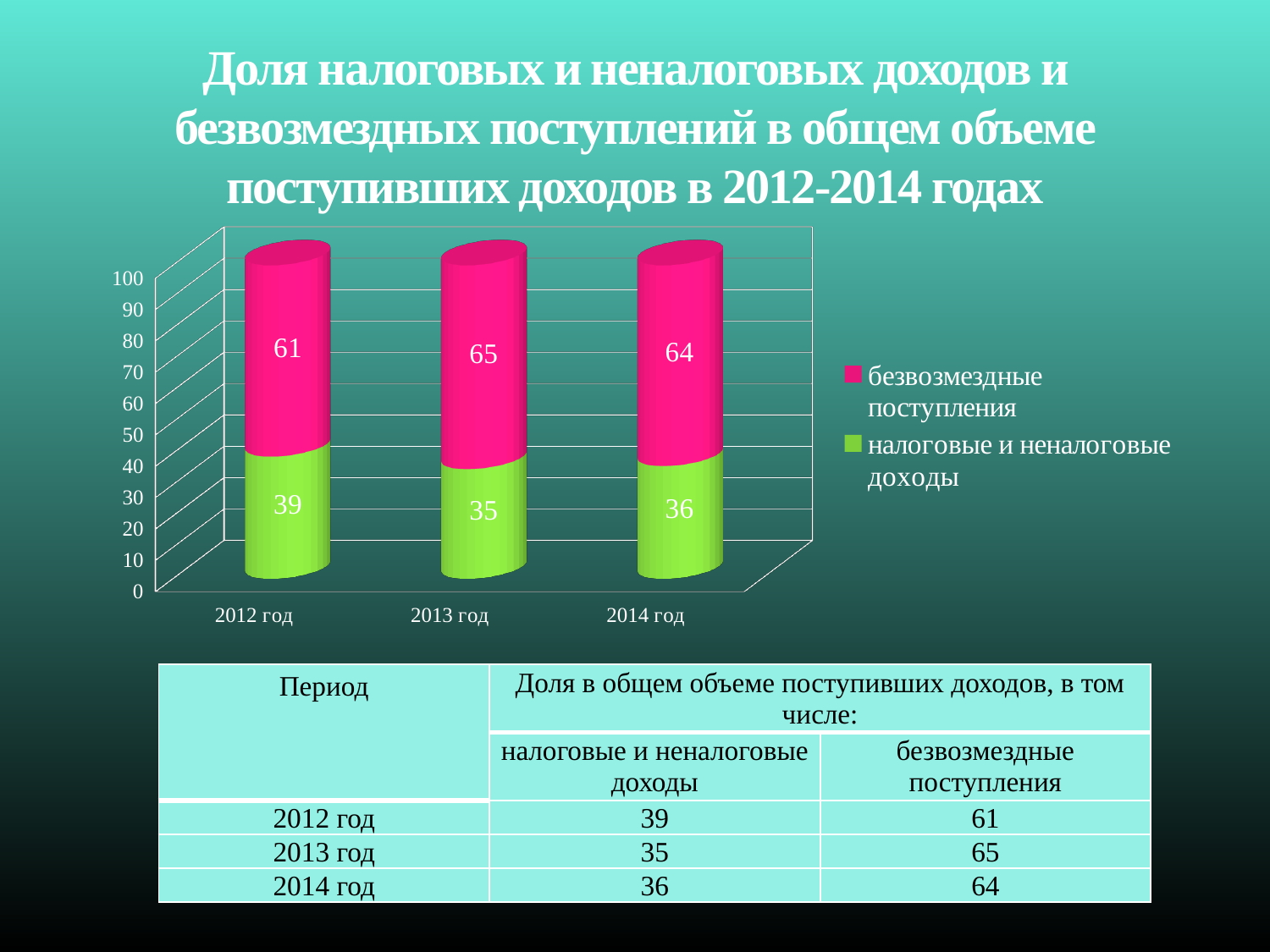
What is the value for налоговые и неналоговые доходы in 2013 год? 35 How many years are shown on the x axis of the chart? 3 Which colour represents безвозмездные поступления in the chart? pink Which is larger in 2014 год: безвозмездные поступления or налоговые и неналоговые доходы? безвозмездные поступления In which year is the value for налоговые и неналоговые доходы the highest? 2012 год What is the total of the stacked bar for 2012 год? 100 What is the value for безвозмездные поступления in 2012 год? 61 What is the difference between безвозмездные поступления and налоговые и неналоговые доходы in 2013 год? 30 What is the value for безвозмездные поступления in 2014 год? 64 In which year is the value for безвозмездные поступления the lowest? 2012 год What kind of chart is shown on the slide? stacked bar chart How many series does the chart legend list? 2